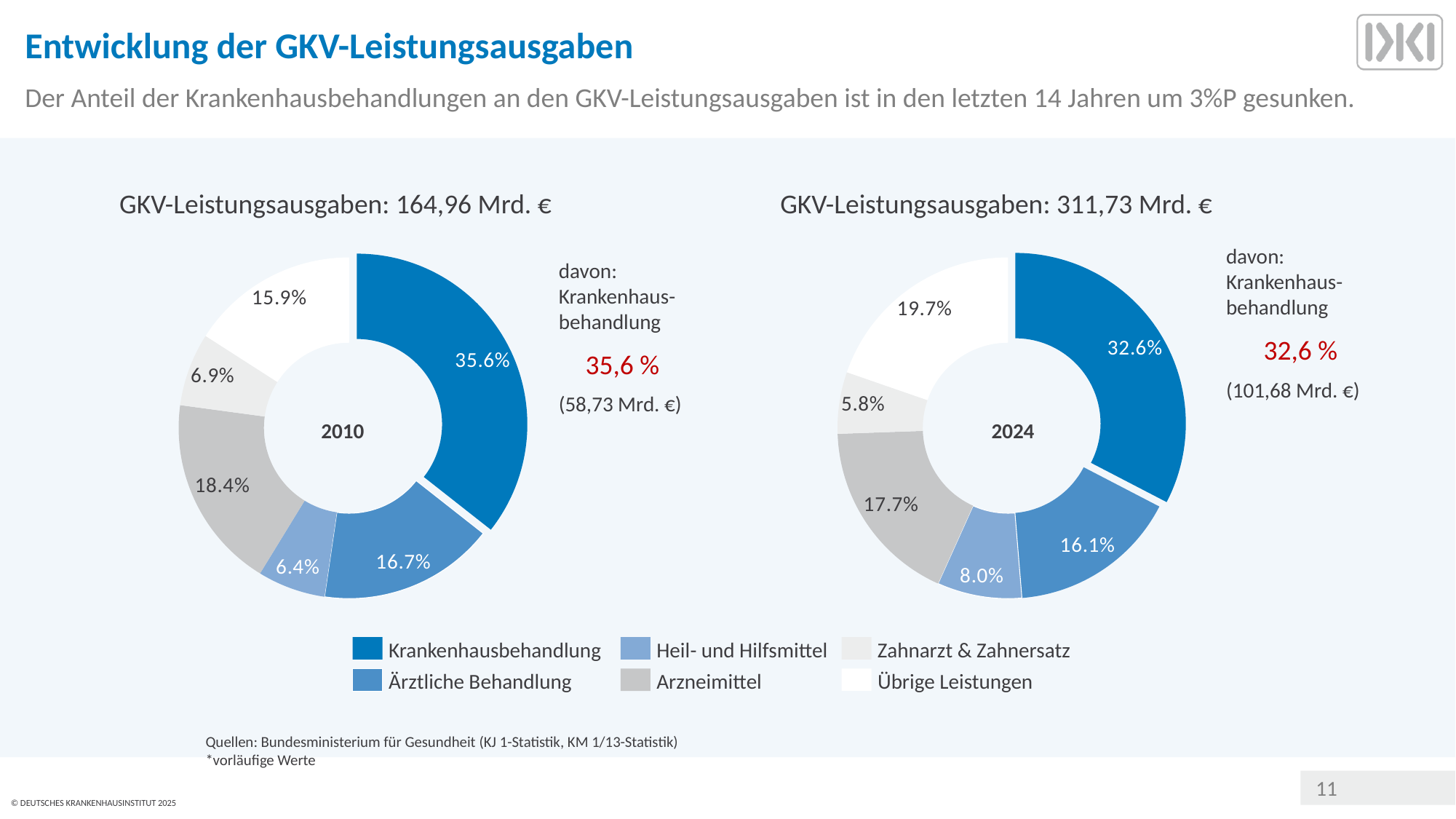
In the 2010 chart, what share of GKV-Leistungsausgaben is Krankenhausbehandlung? 35.6% In the 2024 chart, what share of GKV-Leistungsausgaben is Arzneimittel? 17.7% How many categories does each donut chart show? 6 In the 2010 chart, which category has the smallest share? Heil- und Hilfsmittel What total GKV-Leistungsausgaben is given above the 2024 chart? 311,73 Mrd. € In the 2024 chart, what share is Heil- und Hilfsmittel? 8.0% In the 2024 chart, which category has the smallest share? Zahnarzt & Zahnersatz In the 2010 chart, which category has the largest share? Krankenhausbehandlung What type of chart is used on this slide? Donut (pie) chart By how many percentage points did the share of Krankenhausbehandlung change from the 2010 chart to the 2024 chart? 3.0 percentage points lower In the 2024 chart, which is larger: the share of Übrige Leistungen or the share of Arzneimittel? Übrige Leistungen In the 2010 chart, what is the difference between the shares of Arzneimittel and Übrige Leistungen? 2.5 percentage points